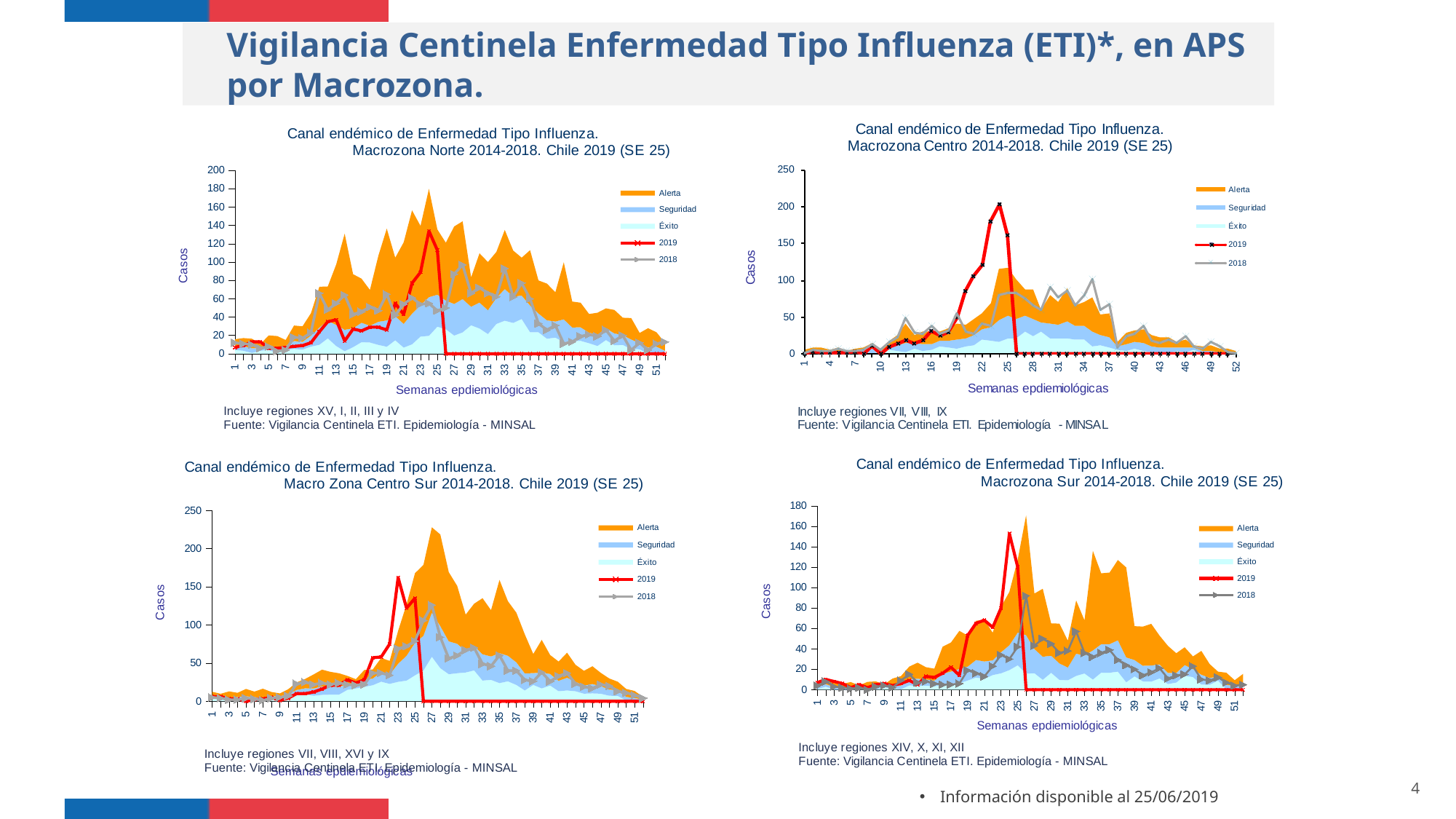
On the Macrozona Centro chart (top right), does the 2019 line rise or fall between week 19 and week 24? rises What are the legend entries on the Macrozona Centro chart (top right)? Alerta, Seguridad, Éxito, 2019, 2018 On the Macrozona Sur chart (bottom right), which line reaches a higher peak, 2019 or 2018? 2019 What is the y-axis label on the Macrozona Sur chart (bottom right)? Casos What is the highest value shown on the y axis of the Macro Zona Centro Sur chart (bottom left)? 250 On the Macrozona Norte chart (top left), which line reaches a higher peak, 2019 or 2018? 2019 How many series does the legend list on the Macrozona Norte chart (top left)? 5 On the Macro Zona Centro Sur chart (bottom left), is the peak value of the 2019 line greater or less than 100? greater On the Macrozona Centro chart (top right), is the peak value of the 2019 line greater or less than 150? greater On the Macrozona Norte chart (top left), is the peak value of the 2019 line greater or less than 120? greater What kind of chart is the Macrozona Norte chart (top left)? combination area and line chart